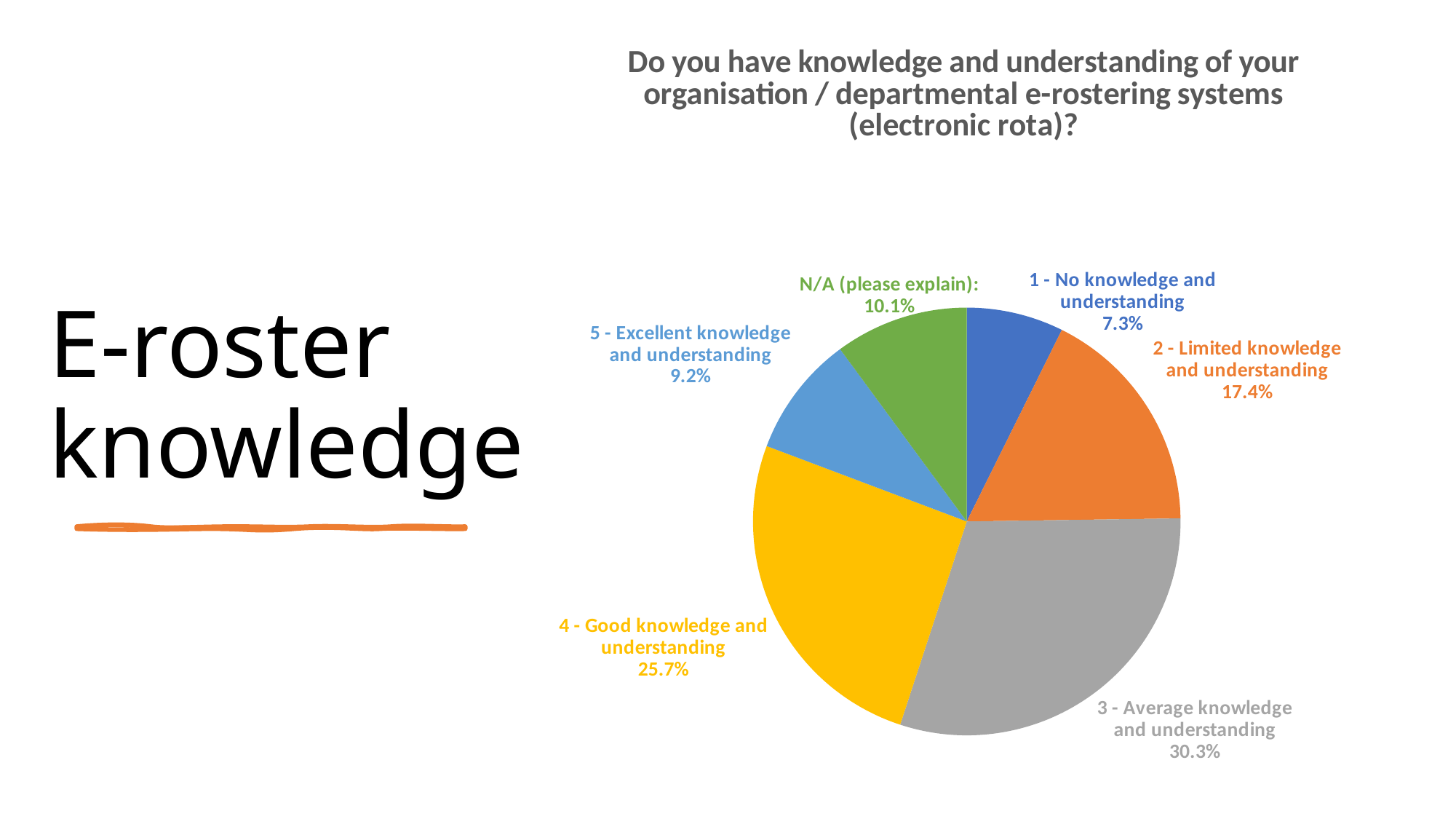
Which is larger: the share for '2 - Limited knowledge and understanding' or the share for 'N/A (please explain):'? 2 - Limited knowledge and understanding What share of the pie is '3 - Average knowledge and understanding'? 30.3% Which category has the smallest slice of the pie? 1 - No knowledge and understanding How many categories are shown in the pie chart? 6 What percentage is shown for '5 - Excellent knowledge and understanding'? 9.2% What percentage is shown for 'N/A (please explain):'? 10.1% Which category has the largest slice of the pie? 3 - Average knowledge and understanding What colour is the slice for '4 - Good knowledge and understanding'? Yellow What kind of chart is shown on the slide? Pie chart What is the difference in percentage points between '4 - Good knowledge and understanding' and '2 - Limited knowledge and understanding'? 8.3 What percentage of respondents answered '1 - No knowledge and understanding'? 7.3% What is the title of the chart? Do you have knowledge and understanding of your organisation / departmental e-rostering systems (electronic rota)?